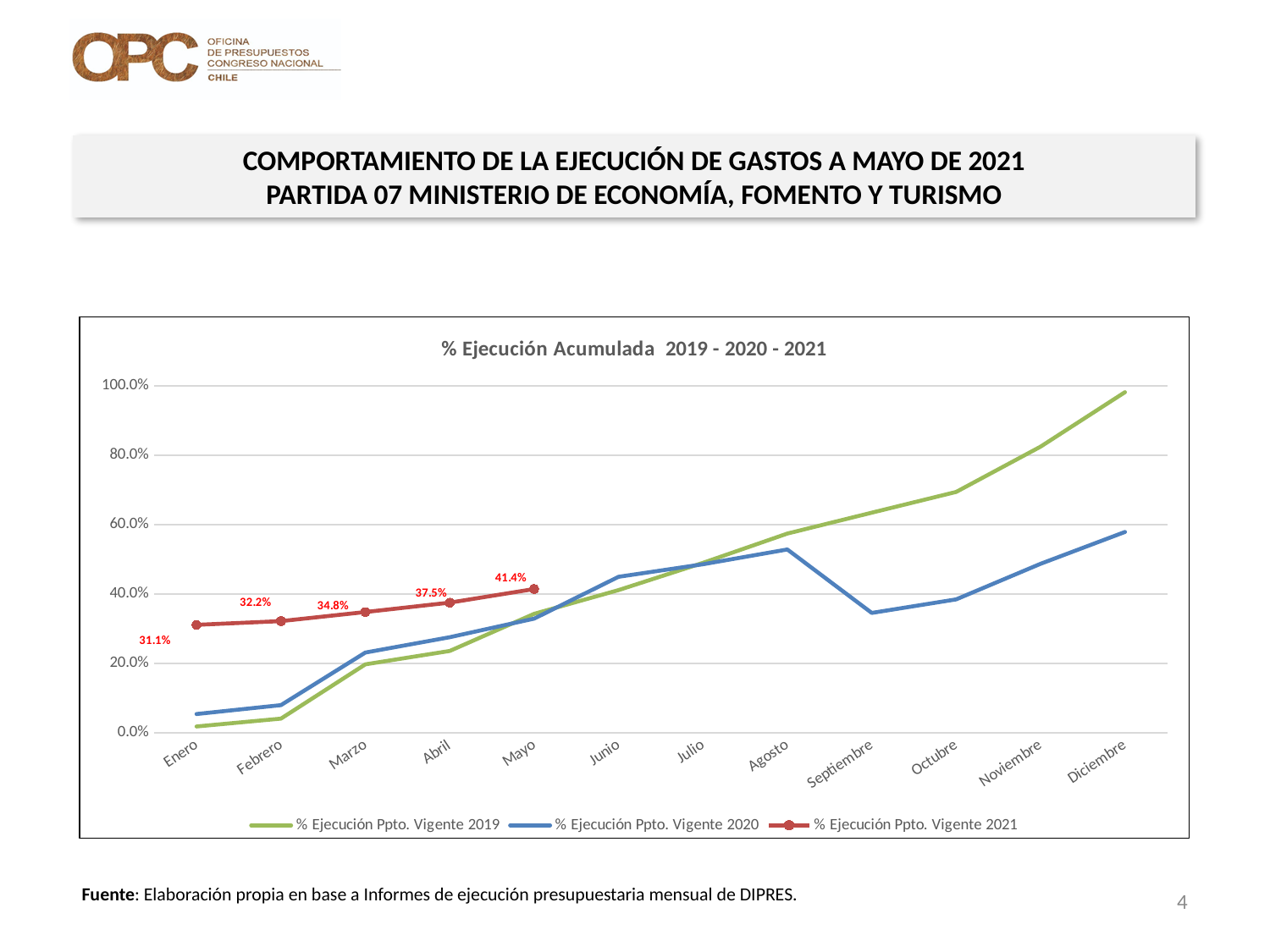
How many months are shown on the x axis? 12 What is the title of the chart? % Ejecución Acumulada 2019 - 2020 - 2021 Is the value for % Ejecución Ppto. Vigente 2020 in Septiembre greater or less than 40.0%? less What is the value of % Ejecución Ppto. Vigente 2021 for Mayo? 41.4% In Diciembre, which series has the larger value: 2019 or 2020? % Ejecución Ppto. Vigente 2019 Is the value for % Ejecución Ppto. Vigente 2019 in Diciembre greater or less than 80.0%? greater What is the value of % Ejecución Ppto. Vigente 2021 for Enero? 31.1% What type of chart is shown on the slide? line chart What is the difference between the 2021 values for Mayo and Enero? 10.3% In which month does the % Ejecución Ppto. Vigente 2021 series reach its highest value? Mayo What is the value of % Ejecución Ppto. Vigente 2021 for Marzo? 34.8% How many series does the legend list? 3